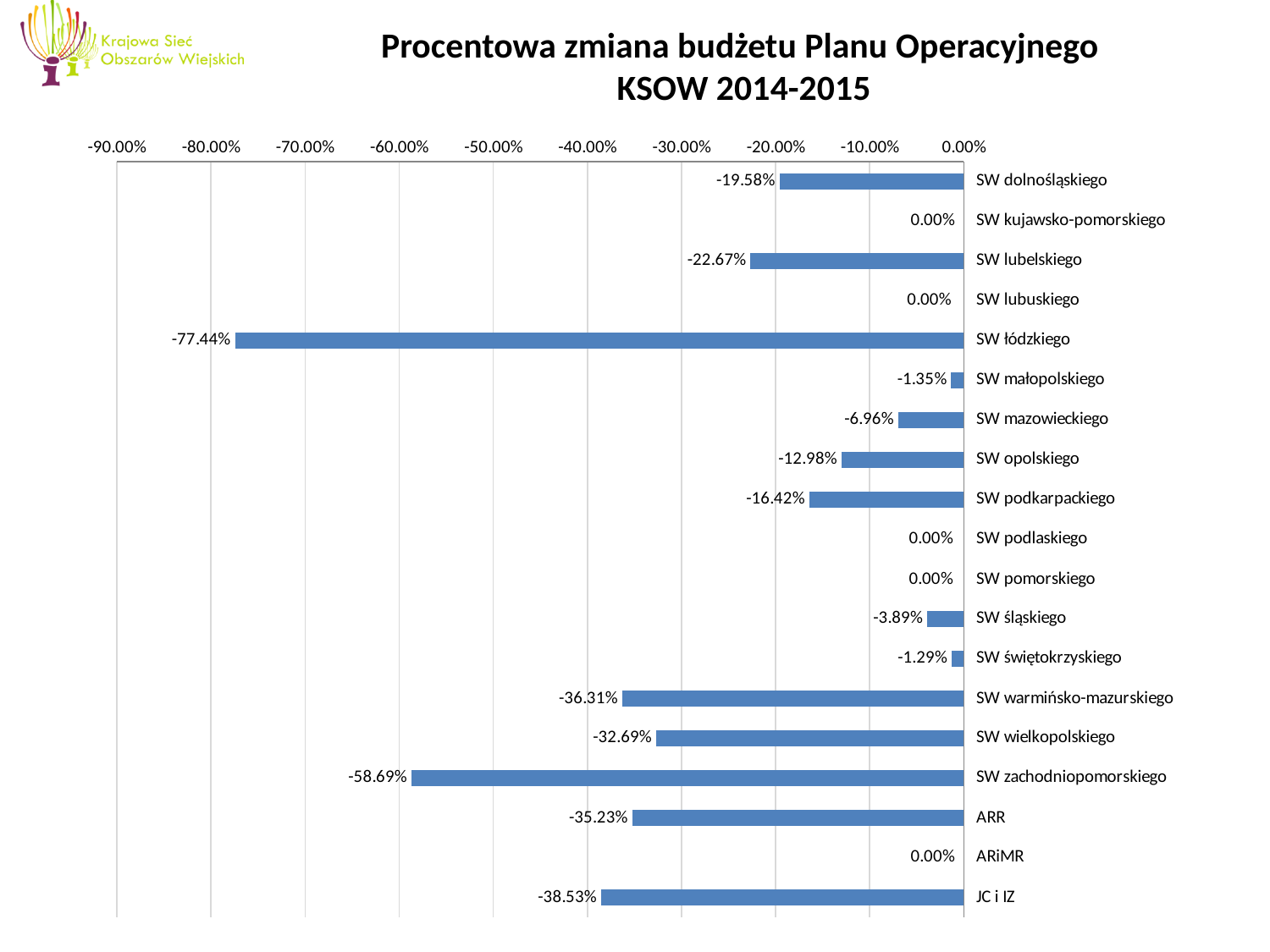
What is the title of the chart? Procentowa zmiana budżetu Planu Operacyjnego KSOW 2014-2015 Which has a larger decrease, SW lubelskiego or SW dolnośląskiego? SW lubelskiego What kind of chart is shown on the slide? Bar chart Which category has the lowest (most negative) value? SW łódzkiego Is the value for ARR greater or less than -30.00%? less How many categories are shown in the chart? 19 What is the value for SW łódzkiego? -77.44% What is the difference between the values for SW warmińsko-mazurskiego and SW wielkopolskiego? 3.62 percentage points What is the value for SW zachodniopomorskiego? -58.69% What is the value for SW mazowieckiego? -6.96% What is the value for JC i IZ? -38.53% How many categories have a value of 0.00%? 5